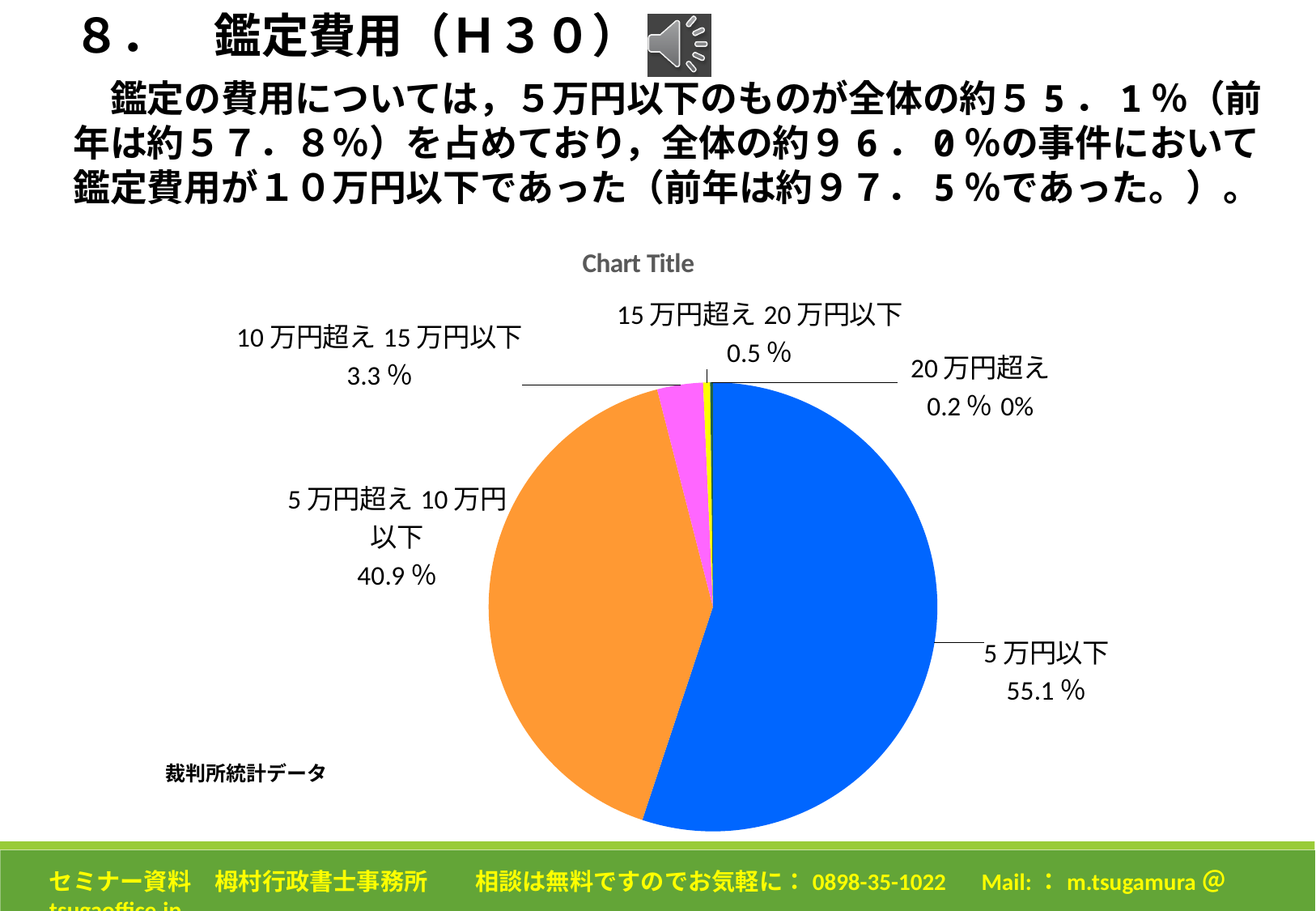
What percentage is shown for the 20万円超え slice? 0.2% What is the combined share of the 5万円以下 and 5万円超え10万円以下 slices? 96.0% What type of chart is shown on the slide? Pie chart What is the value for the 15万円超え20万円以下 slice? 0.5% Which slice is larger: 10万円超え15万円以下 or 15万円超え20万円以下? 10万円超え15万円以下 What percentage of the pie chart is the 5万円以下 slice? 55.1% How many percentage points larger is the 5万円以下 slice than the 5万円超え10万円以下 slice? 14.2 percentage points What percentage is labelled for 10万円超え15万円以下? 3.3% What is the value shown for the 5万円超え10万円以下 slice? 40.9% How many slices does the pie chart have? 5 Which category has the largest slice of the pie chart? 5万円以下 Which category has the smallest slice of the pie chart? 20万円超え